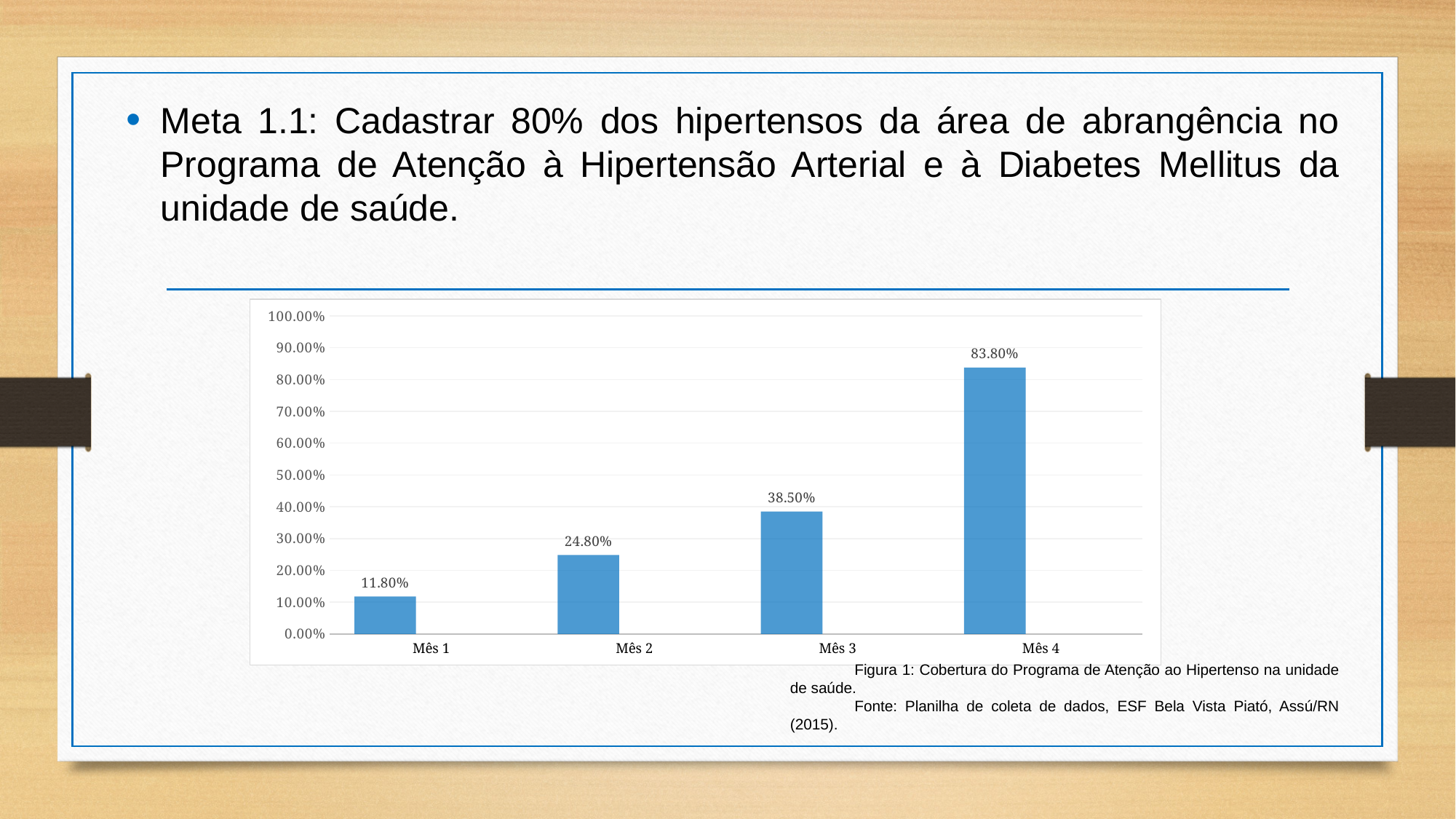
How many months are shown on the x axis? 4 What is the value for Mês 1? 11.80% Is the value for Mês 4 greater or less than 80.00%? greater What is the difference between the values for Mês 2 and Mês 1? 13.00% Which is larger, the value for Mês 2 or the value for Mês 3? Mês 3 What is the difference between the values for Mês 4 and Mês 3? 45.30% What is the value for Mês 3? 38.50% Which month has the highest value? Mês 4 Do the values rise or fall from Mês 1 to Mês 4? rise What kind of chart is shown on the slide? bar chart What is the value for Mês 4? 83.80% Which month has the lowest value? Mês 1